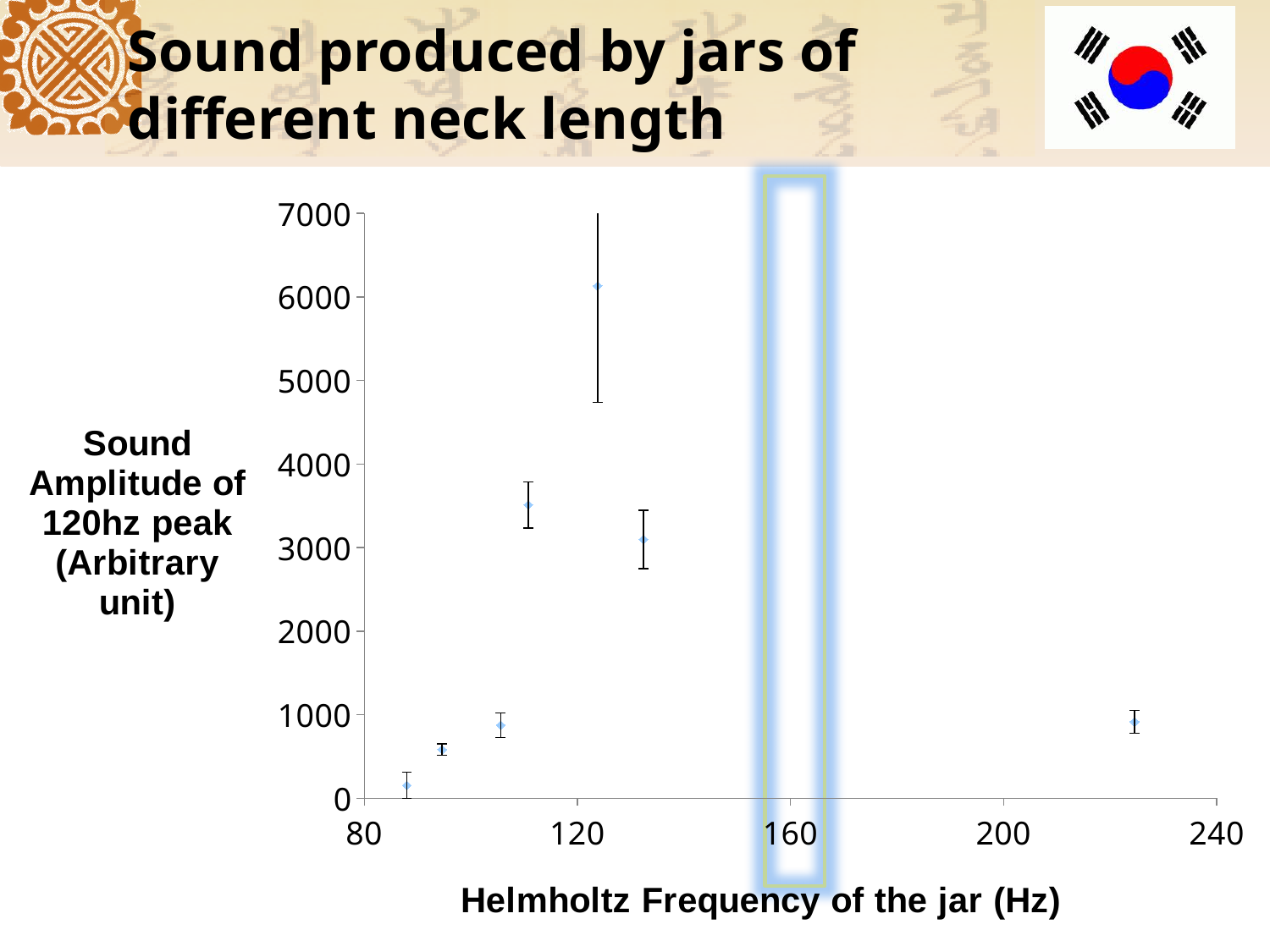
Is the sound amplitude for the point near 225 Hz greater or less than 2000? less What is the title of the x axis? Helmholtz Frequency of the jar (Hz) Is the sound amplitude for the point near 111 Hz greater or less than 3000? greater What is the maximum value shown on the y axis? 7000 What is the label on the y axis? Sound Amplitude of 120hz peak (Arbitrary unit) How many data points are plotted on the chart? 7 Which is larger: the sound amplitude of the point near 95 Hz or the point near 111 Hz? the point near 111 Hz Which is larger: the sound amplitude of the point near 124 Hz or the point near 132 Hz? the point near 124 Hz Does the sound amplitude rise or fall as the Helmholtz frequency increases from 80 Hz to about 124 Hz? rise Is the sound amplitude for the point near 88 Hz greater or less than 1000? less What kind of chart is shown on the slide? scatter chart